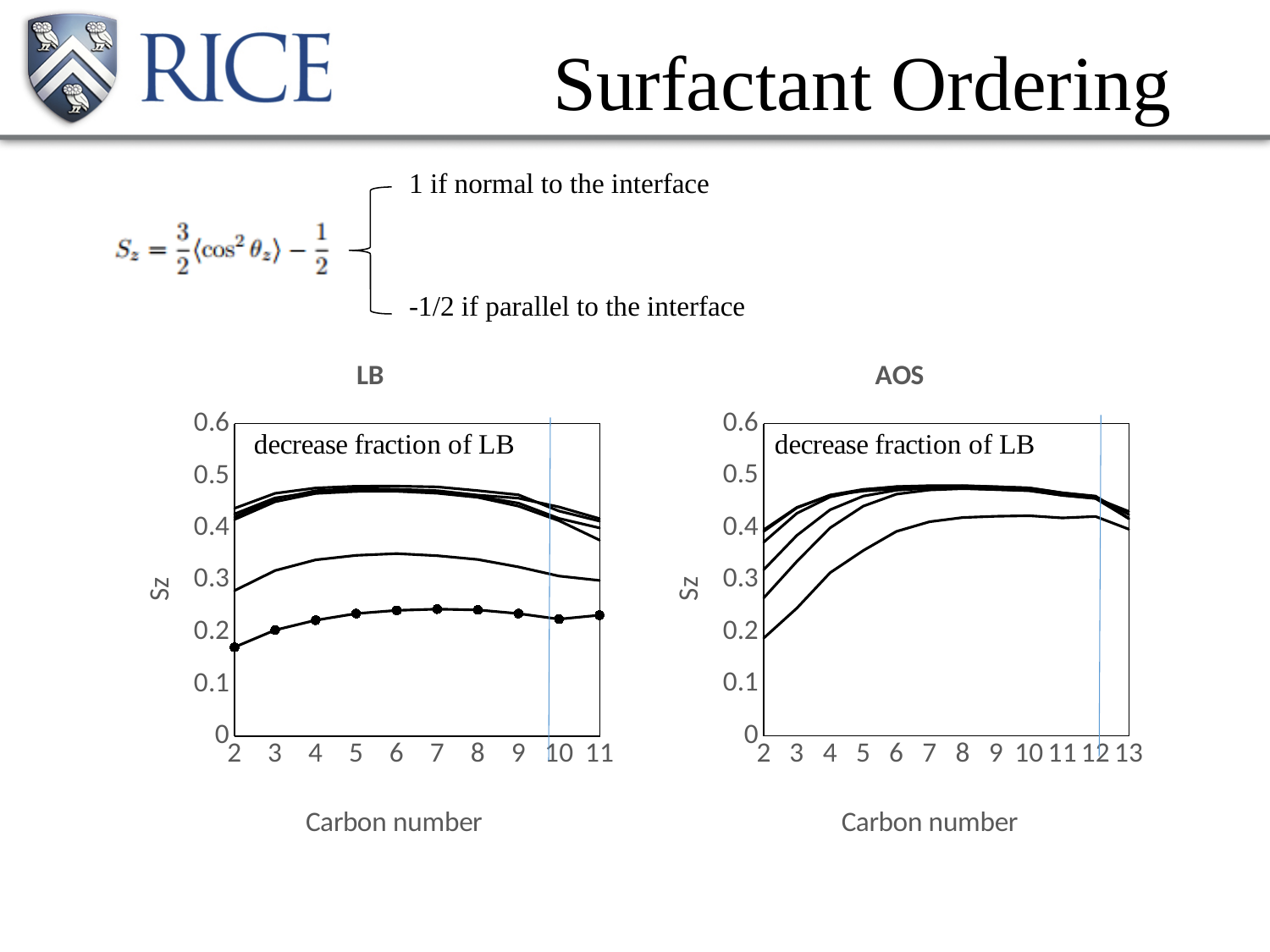
On the LB chart, is the value of the lowest line (with circular markers) at carbon number 2 greater or less than 0.2? less On the LB chart, how many carbon numbers are marked along the x axis? 10 On the AOS chart, does the lowest line rise or fall from carbon number 2 to carbon number 7? rise On the LB chart, is the value of the lowest line (with circular markers) at carbon number 7 greater or less than 0.2? greater On the AOS chart, is the value of the topmost line at carbon number 7 greater or less than 0.4? greater What kind of chart is the AOS chart? line chart What is the label on the x axis of the AOS chart? Carbon number On the AOS chart, how many carbon numbers are marked along the x axis? 12 On the LB chart, does the lowest line (with circular markers) rise or fall from carbon number 2 to carbon number 7? rise What kind of chart is the LB chart? line chart